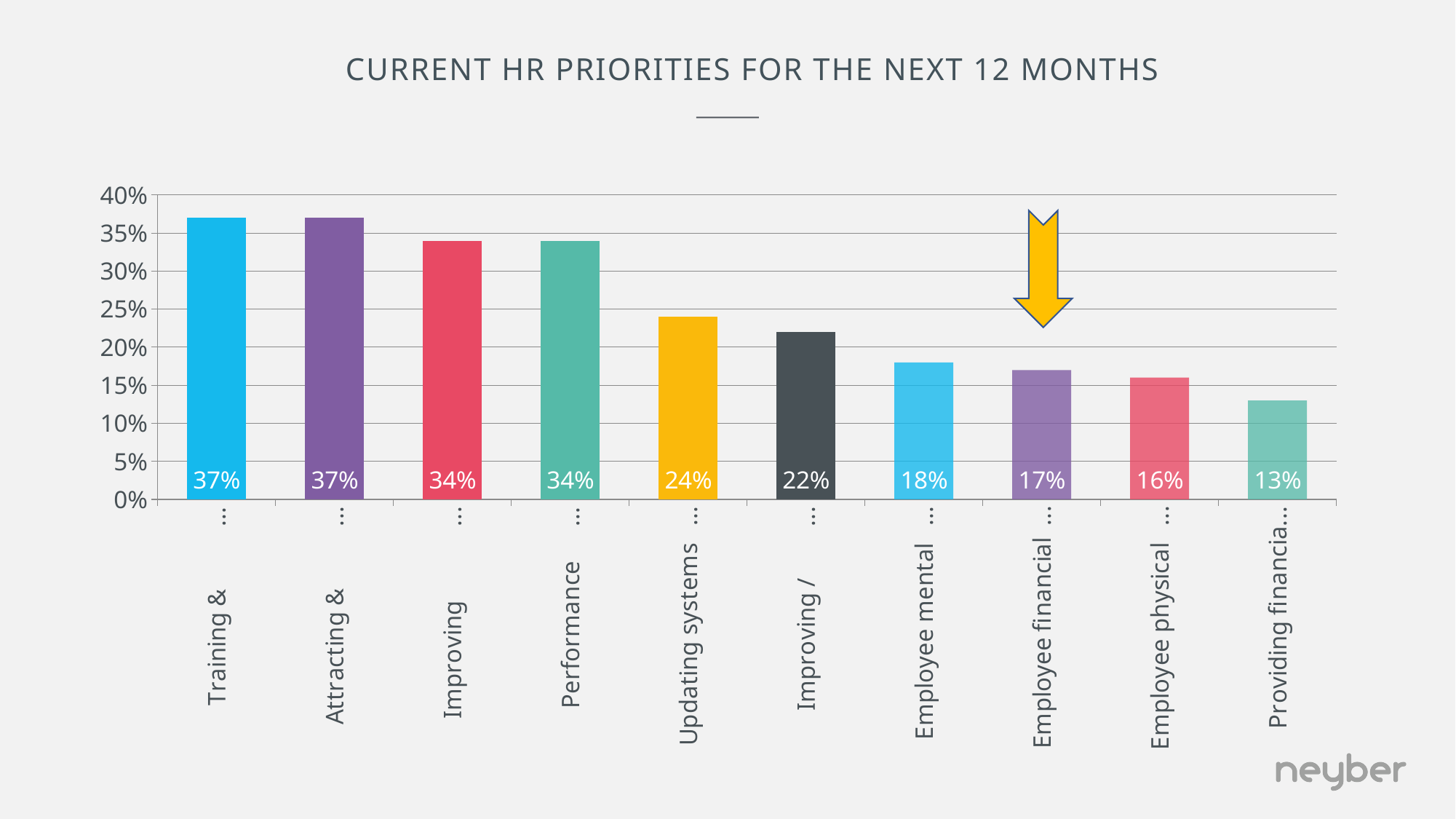
What is the difference between the values for 'Training &' and 'Updating systems'? 13% Which is larger, the value for 'Performance' or the value for 'Updating systems'? Performance How many bars are shown in the chart? 10 What kind of chart is shown on the slide? Bar chart Do the values rise or fall from left to right along the x axis? Fall What is the value for the 'Employee physical' category? 16% What is the value for the 'Updating systems' category? 24% Which category has the lowest value? Providing financia... What is the title of the chart? CURRENT HR PRIORITIES FOR THE NEXT 12 MONTHS What is the value for the 'Employee financial' category? 17% What is the value for the 'Employee mental' category? 18% What is the difference between the values for 'Employee mental' and 'Employee financial'? 1%